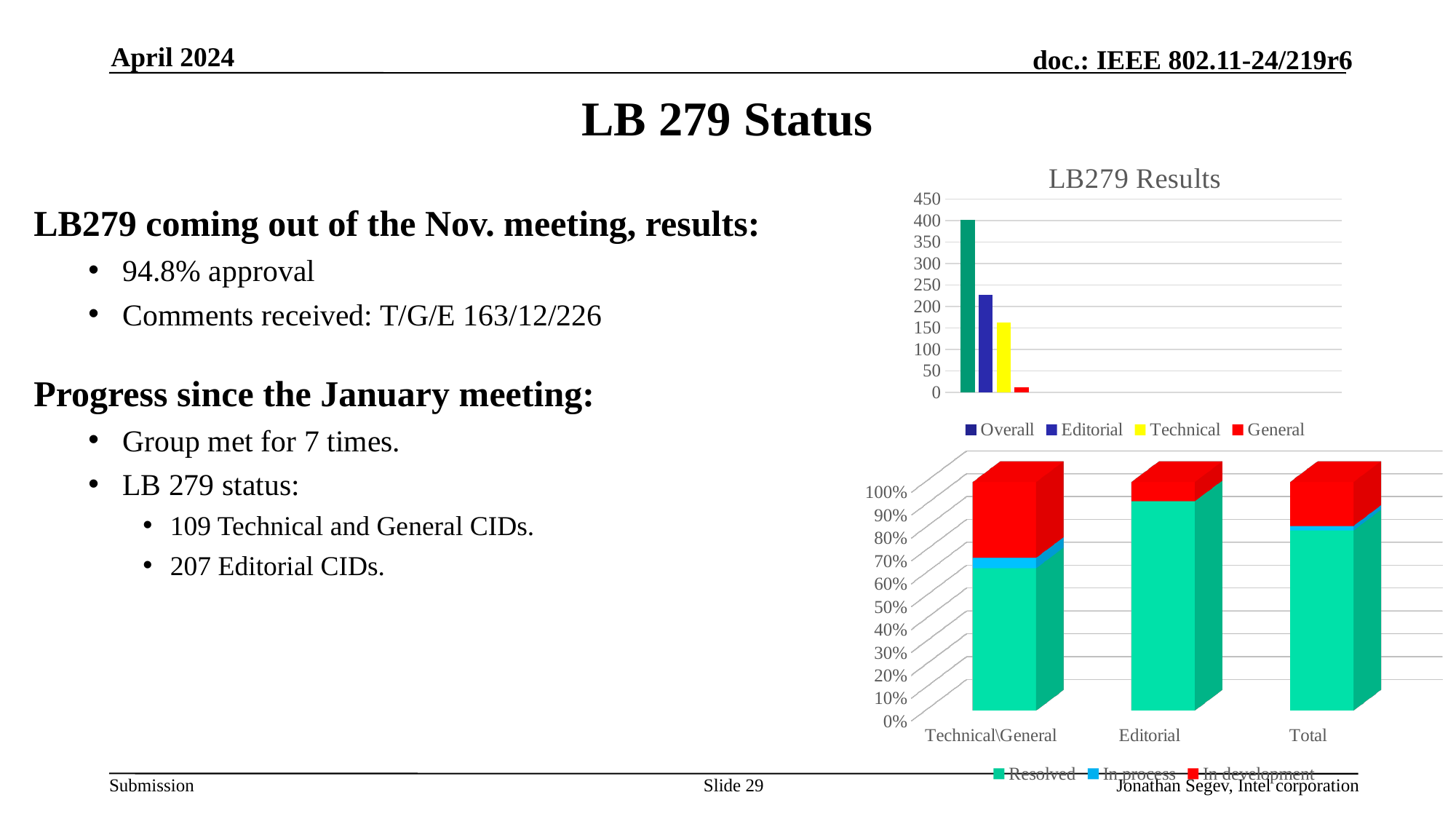
In the stacked bar chart at the bottom right, which category has the largest Resolved share? Editorial In the 'LB279 Results' chart, which series has the tallest bar? Overall In the 'LB279 Results' chart, is the value for Editorial greater or less than 200? greater What kind of chart is the 'LB279 Results' chart at the top right? bar chart In the 'LB279 Results' chart, is the value for General greater or less than 50? less How many series does the legend of the 'LB279 Results' chart list? 4 In the stacked bar chart at the bottom right, is the Resolved share for Technical\General greater or less than 60%? greater In the 'LB279 Results' chart, which series has the shortest bar? General How many categories are shown on the x axis of the stacked bar chart at the bottom right? 3 In the 'LB279 Results' chart, what colour is the Technical bar? yellow In the 'LB279 Results' chart, which is larger, the Editorial bar or the Technical bar? Editorial